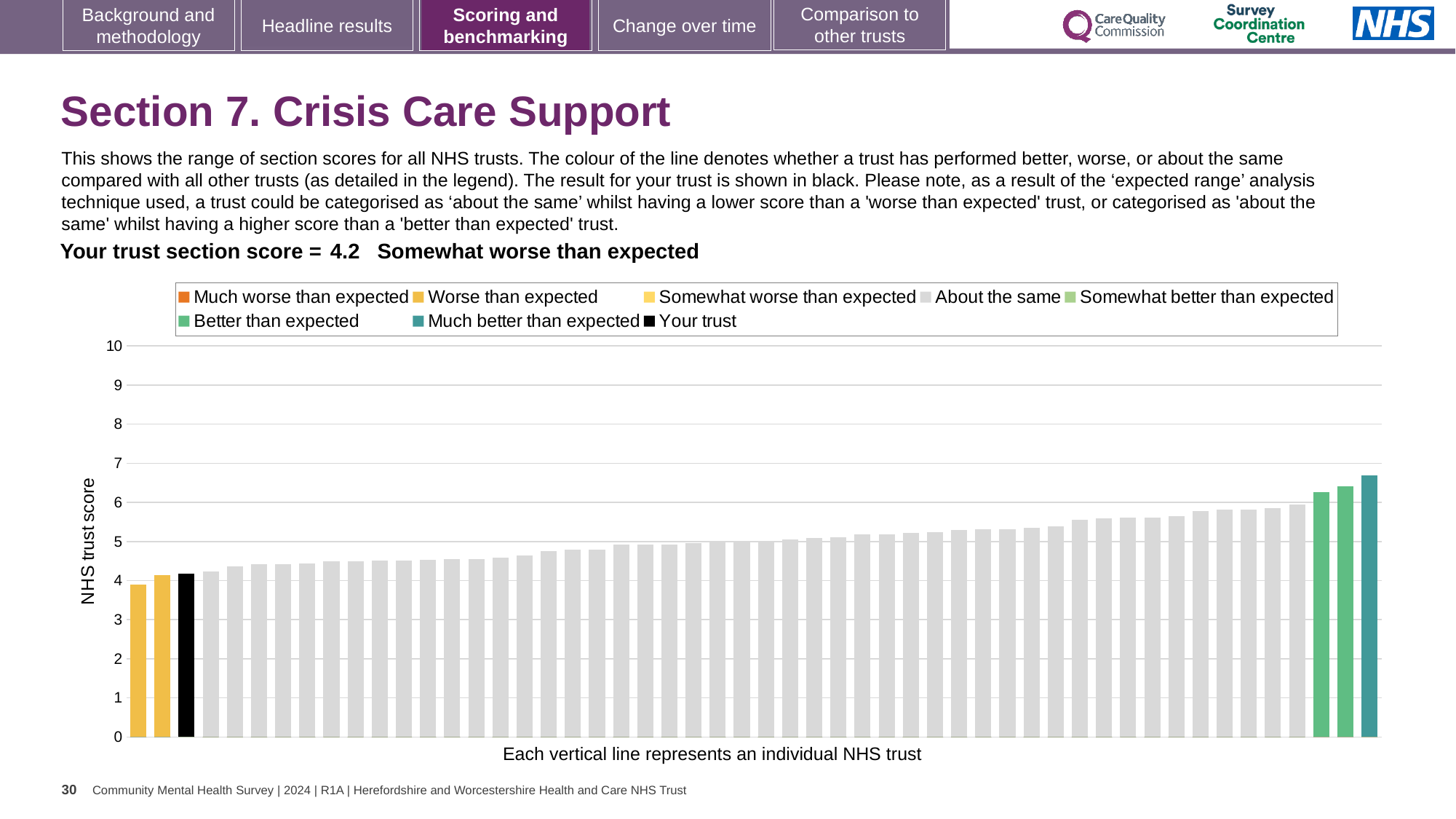
What kind of chart is shown on the slide? bar chart Is the value of the tallest bar greater or less than 7? less Is the black 'Your trust' bar higher or lower than the rightmost bar? lower What is the section score for your trust shown on the slide? 4.2 How many entries does the chart legend list? 8 Do the bar values rise or fall from left to right along the x axis? rise Is the value of the black 'Your trust' bar greater or less than 5? less How many bars are to the left of the black 'Your trust' bar? 2 What is the title of the vertical axis? NHS trust score Is the value of the tallest bar greater or less than 6? greater Which bar is the highest: the leftmost bar or the rightmost bar? the rightmost bar Which category does the slide say your trust's section score falls into? Somewhat worse than expected